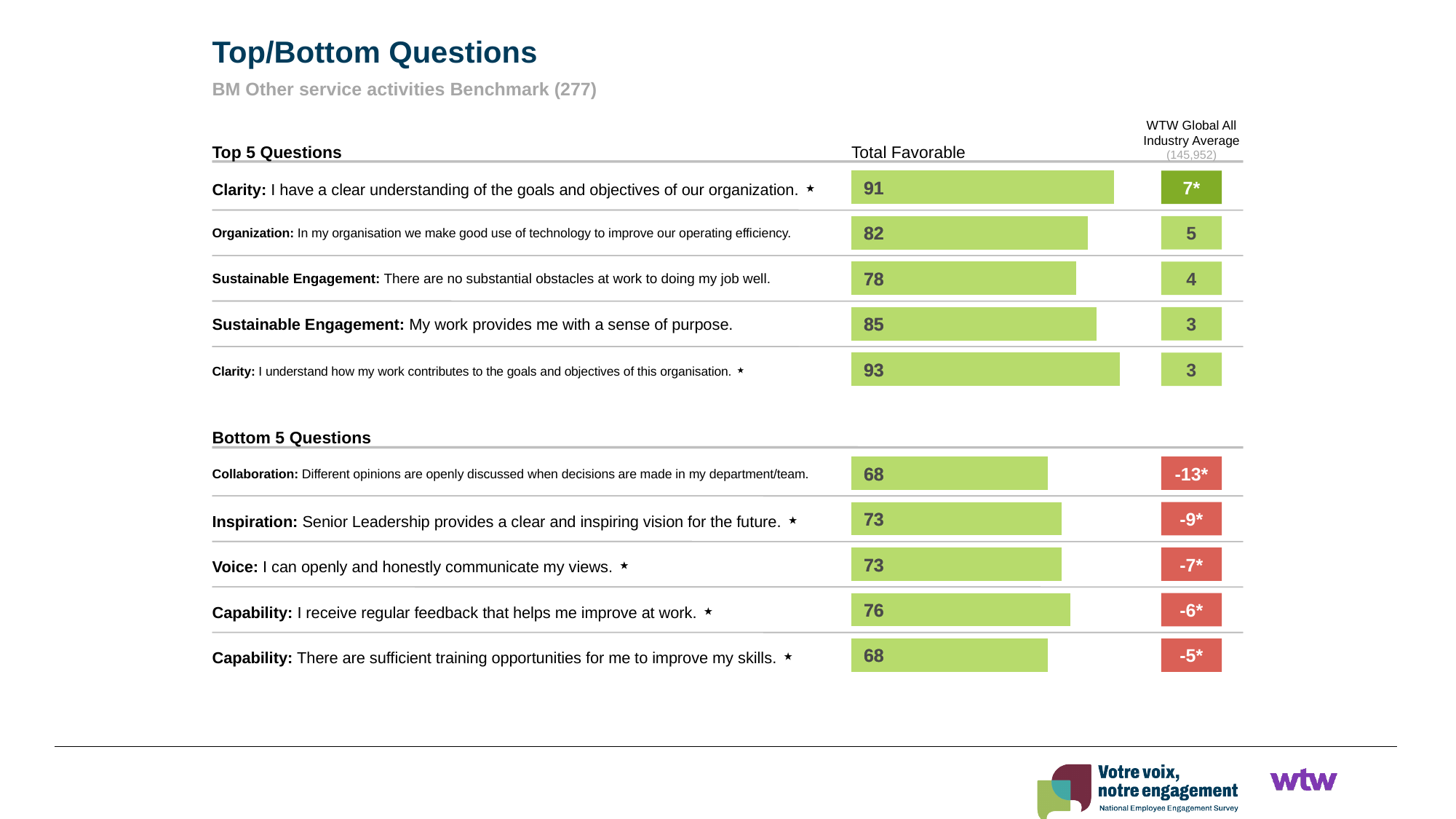
In the Top 5 Questions chart, what is the WTW Global All Industry Average difference shown for "Clarity: I have a clear understanding of the goals and objectives of our organization"? 7* In the Bottom 5 Questions chart, which question has the highest Total Favorable value? Capability: I receive regular feedback that helps me improve at work. What kind of chart is used to show the Total Favorable values on this slide? bar chart How many questions are listed in the Bottom 5 Questions chart? 5 In the Top 5 Questions chart, what is the difference in Total Favorable between "Clarity: I understand how my work contributes to the goals and objectives of this organisation" and "Sustainable Engagement: My work provides me with a sense of purpose"? 8 In the Bottom 5 Questions chart, is the Total Favorable value for "Inspiration: Senior Leadership provides a clear and inspiring vision for the future" larger or smaller than the value for "Capability: There are sufficient training opportunities for me to improve my skills"? larger In the Bottom 5 Questions chart, what is the WTW Global All Industry Average difference shown for "Collaboration: Different opinions are openly discussed when decisions are made in my department/team"? -13* In the Top 5 Questions chart, which question has the lowest Total Favorable value? Sustainable Engagement: There are no substantial obstacles at work to doing my job well. In the Bottom 5 Questions chart, what is the Total Favorable value for "Capability: I receive regular feedback that helps me improve at work"? 76 In the Top 5 Questions chart, what is the Total Favorable value for "Organization: In my organisation we make good use of technology to improve our operating efficiency"? 82 What is the subtitle shown under the slide title "Top/Bottom Questions"? BM Other service activities Benchmark (277) In the Top 5 Questions chart, which question has the highest Total Favorable value? Clarity: I understand how my work contributes to the goals and objectives of this organisation.